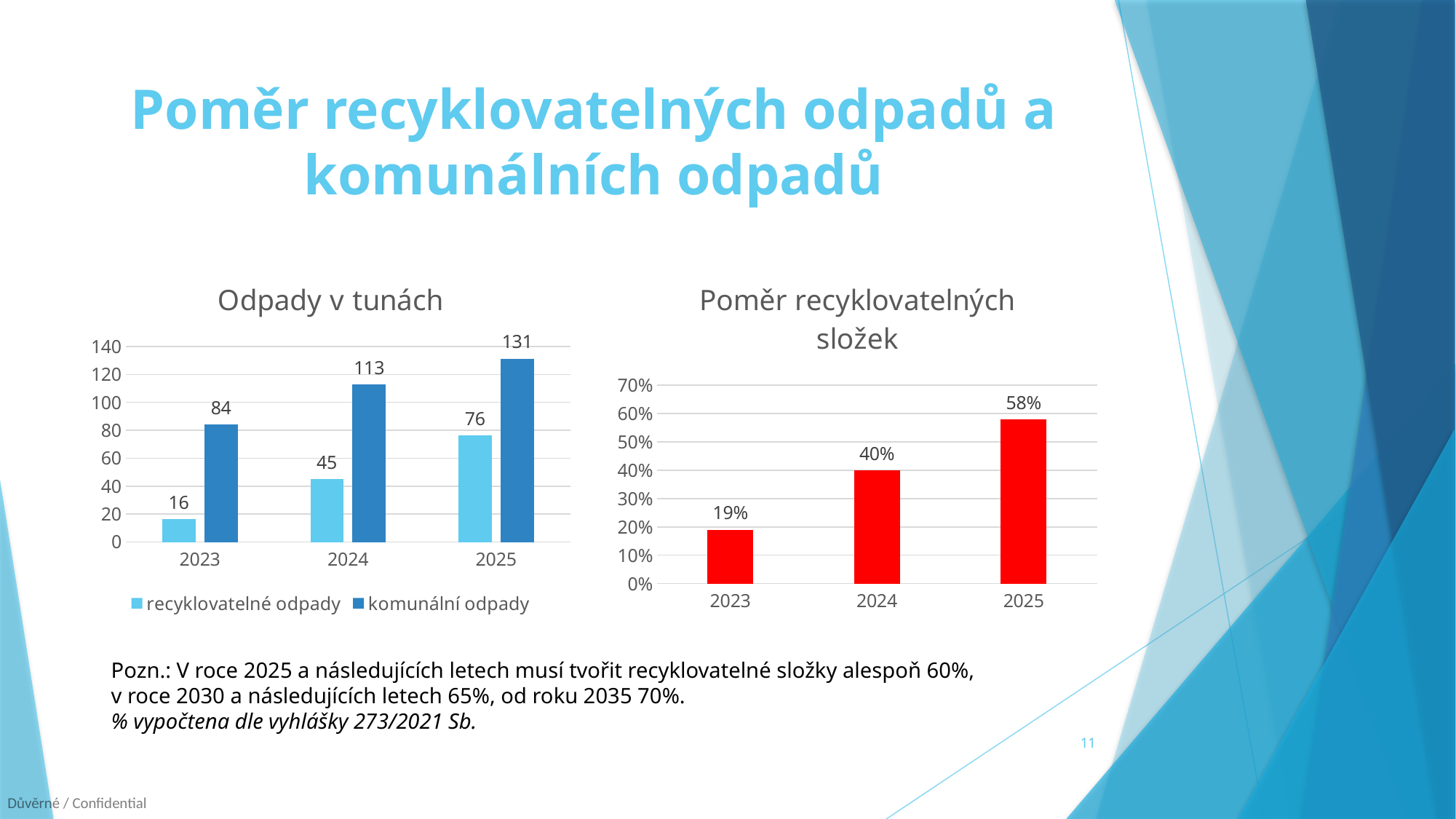
In the 'Odpady v tunách' chart, what is the value for komunální odpady in 2025? 131 In the 'Odpady v tunách' chart, how many series does the legend list? 2 In the 'Odpady v tunách' chart, is the value for komunální odpady in 2024 greater or less than 100? greater In the 'Odpady v tunách' chart, which year has the lowest value for recyklovatelné odpady? 2023 What kind of chart is the 'Poměr recyklovatelných složek' chart? bar chart In the 'Odpady v tunách' chart, which year has the highest value for komunální odpady? 2025 In the 'Poměr recyklovatelných složek' chart, what is the value for 2023? 19% In the 'Poměr recyklovatelných složek' chart, what is the value for 2025? 58% In the 'Odpady v tunách' chart, what is the difference between komunální odpady and recyklovatelné odpady in 2023? 68 In the 'Odpady v tunách' chart, what is the value for recyklovatelné odpady in 2024? 45 In the 'Poměr recyklovatelných složek' chart, what is the difference between the 2025 and 2024 values? 18% In the 'Poměr recyklovatelných složek' chart, do the values rise or fall from 2023 to 2025? rise